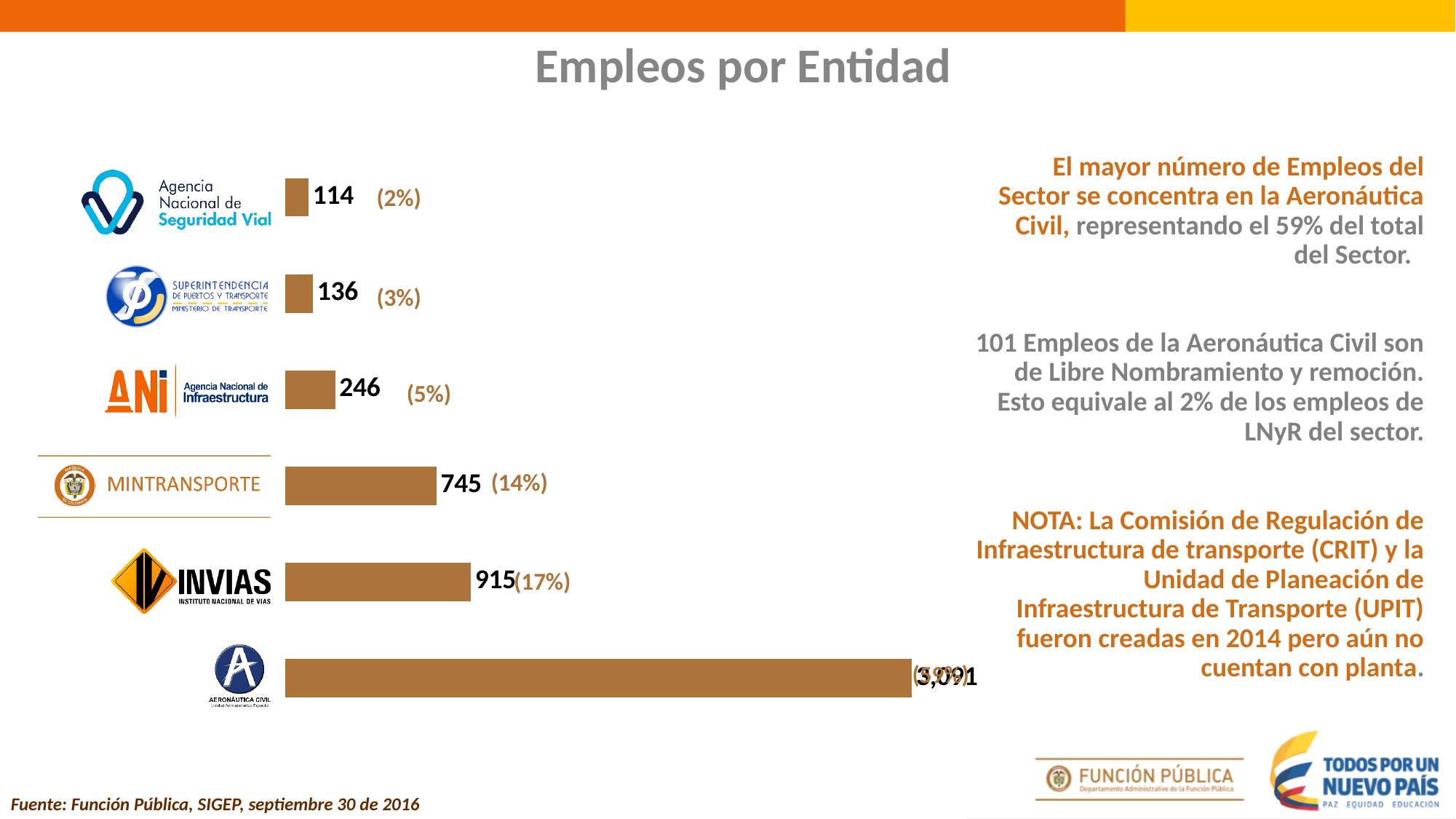
What kind of chart is shown on the slide? bar chart What is the number of employees for Superintendencia de Puertos y Transporte? 136 What percentage of the sector's employees does Mintransporte represent? 14% Which entity has the highest number of employees? Aeronáutica Civil What is the difference in employees between INVIAS and Mintransporte? 170 How many entities are shown in the chart? 6 What is the number of employees for Agencia Nacional de Seguridad Vial? 114 What is the number of employees for ANI (Agencia Nacional de Infraestructura)? 246 What is the number of employees for INVIAS? 915 Which entity has the lowest number of employees? Agencia Nacional de Seguridad Vial What is the number of employees for Mintransporte? 745 What is the title of the chart? Empleos por Entidad